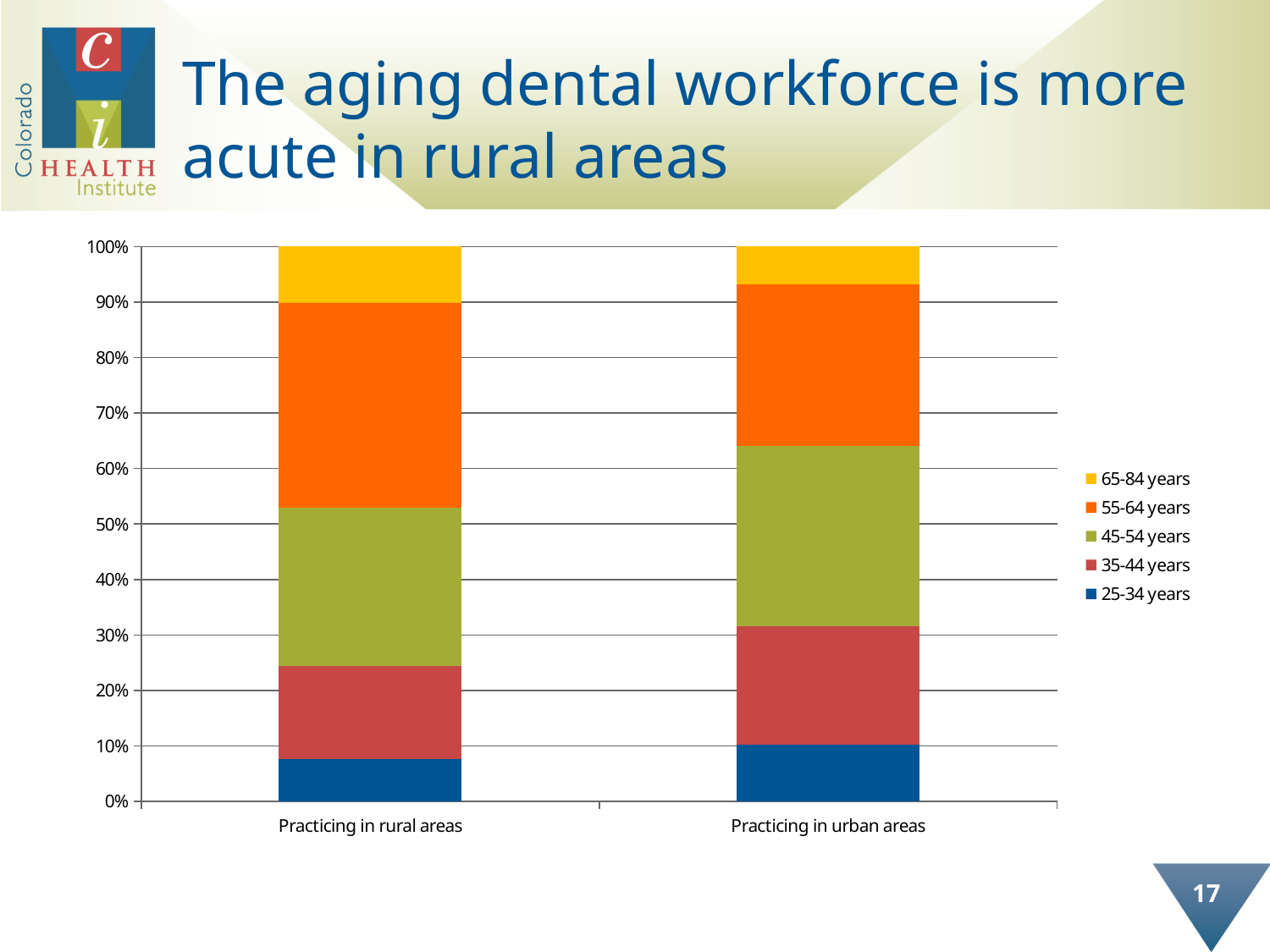
Is the 55-64 years segment larger for Practicing in rural areas or Practicing in urban areas? Practicing in rural areas What is the total height of the stacked bar for Practicing in rural areas? 100% Is the 55-64 years segment for Practicing in urban areas greater or less than 20%? greater Which age group makes up the largest segment of the Practicing in rural areas bar? 55-64 years How many categories are shown on the x axis of the chart? 2 Is the 65-84 years segment larger for Practicing in rural areas or Practicing in urban areas? Practicing in rural areas Is the 35-44 years segment for Practicing in rural areas greater or less than 20%? less How many series does the legend list? 5 Is the 25-34 years segment for Practicing in urban areas greater or less than 20%? less What kind of chart is shown on the slide? stacked bar chart Which colour represents the 45-54 years series in the legend? green